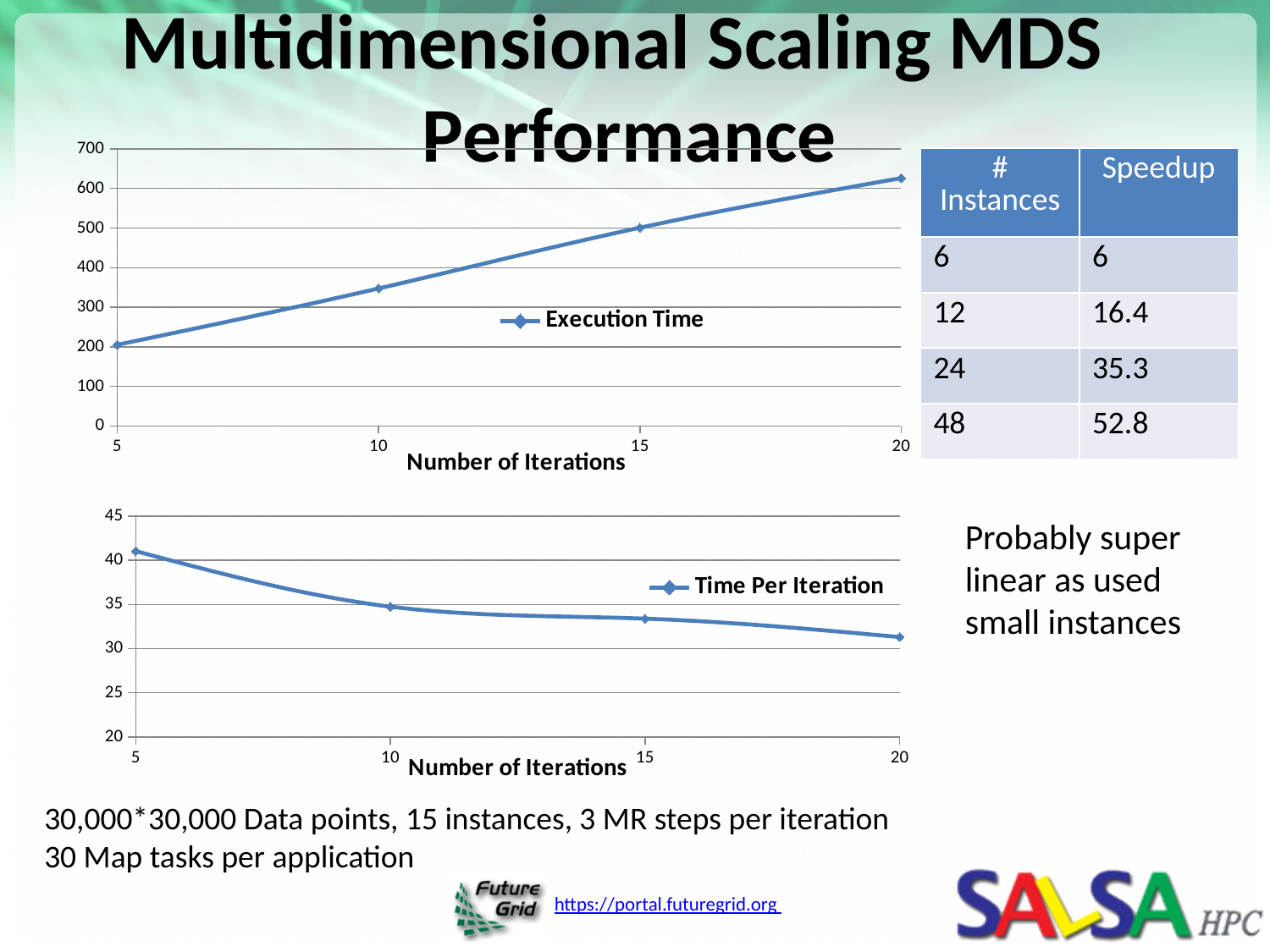
In the top chart, is the Execution Time at 10 iterations greater or less than 300? greater How many series does the legend of the bottom chart list? 1 What kind of chart is the bottom chart (Time Per Iteration)? line chart In the bottom chart, is the Time Per Iteration at 20 iterations greater or less than 35? less How many data points are plotted in the top chart (Execution Time)? 4 In the bottom chart, does Time Per Iteration rise or fall as the Number of Iterations increases? fall What kind of chart is the top chart (Execution Time)? line chart In the top chart, which Number of Iterations has the lowest Execution Time? 5 In the top chart, is the Execution Time at 20 iterations greater or less than 600? greater In the top chart, does Execution Time rise or fall as the Number of Iterations increases? rise What is the x-axis title of the bottom chart? Number of Iterations